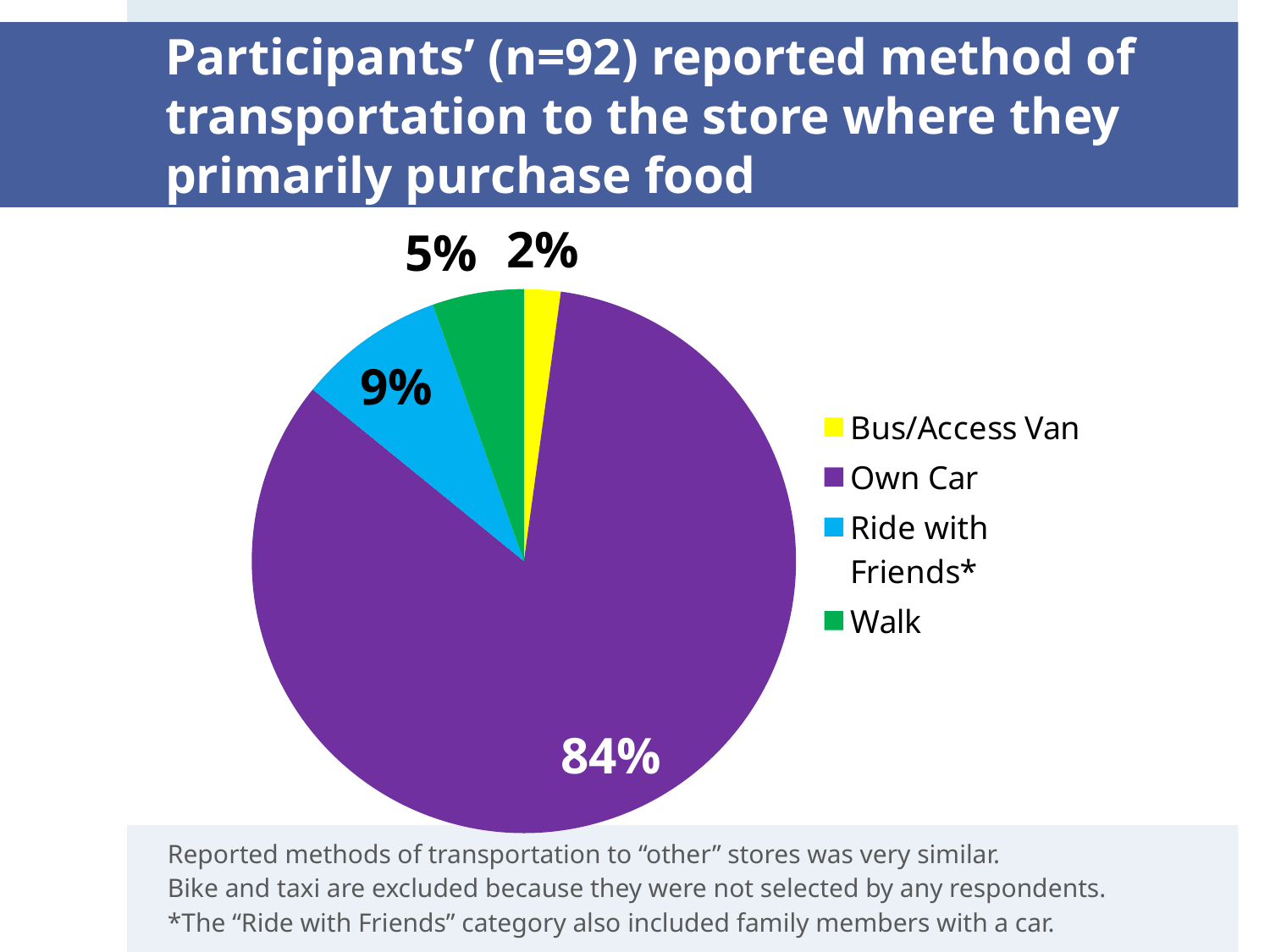
What is the difference in percentage points between Own Car and Ride with Friends? 75 What share of participants reported walking? 5% Which is larger, the share for Walk or the share for Ride with Friends? Ride with Friends What is the difference in percentage points between Walk and Bus/Access Van? 3 Which transportation method has the largest share? Own Car What share of participants reported riding with friends? 9% What share of participants reported using the bus/access van? 2% How many categories does the pie chart show? 4 Which transportation method has the smallest share? Bus/Access Van What colour represents Own Car in the pie chart? purple What kind of chart is shown on the slide? pie chart